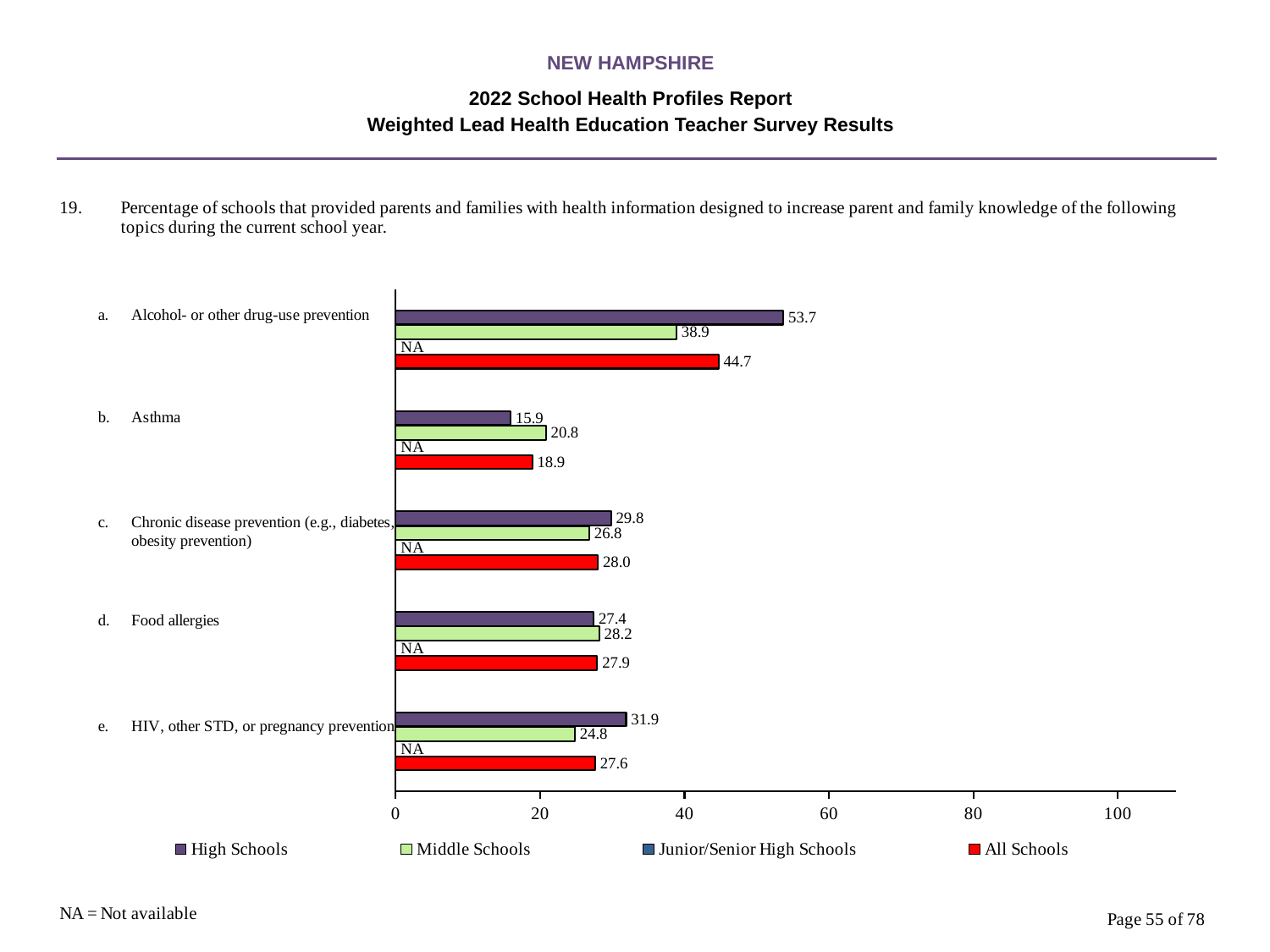
What is the value for All Schools for Food allergies? 27.9 What is the value for Middle Schools for HIV, other STD, or pregnancy prevention? 24.8 What is the difference between the High Schools and Middle Schools values for Alcohol- or other drug-use prevention? 14.8 Which topic has the highest value for High Schools? Alcohol- or other drug-use prevention How many topics are shown on the chart? 5 What is the value for High Schools for Alcohol- or other drug-use prevention? 53.7 Which topic has the lowest value for All Schools? Asthma How many series does the legend list? 4 Which is larger for Asthma: the High Schools value or the Middle Schools value? Middle Schools What is the value for Middle Schools for Asthma? 20.8 What kind of chart is shown on the slide? Bar chart What value is shown for Junior/Senior High Schools for each topic? NA